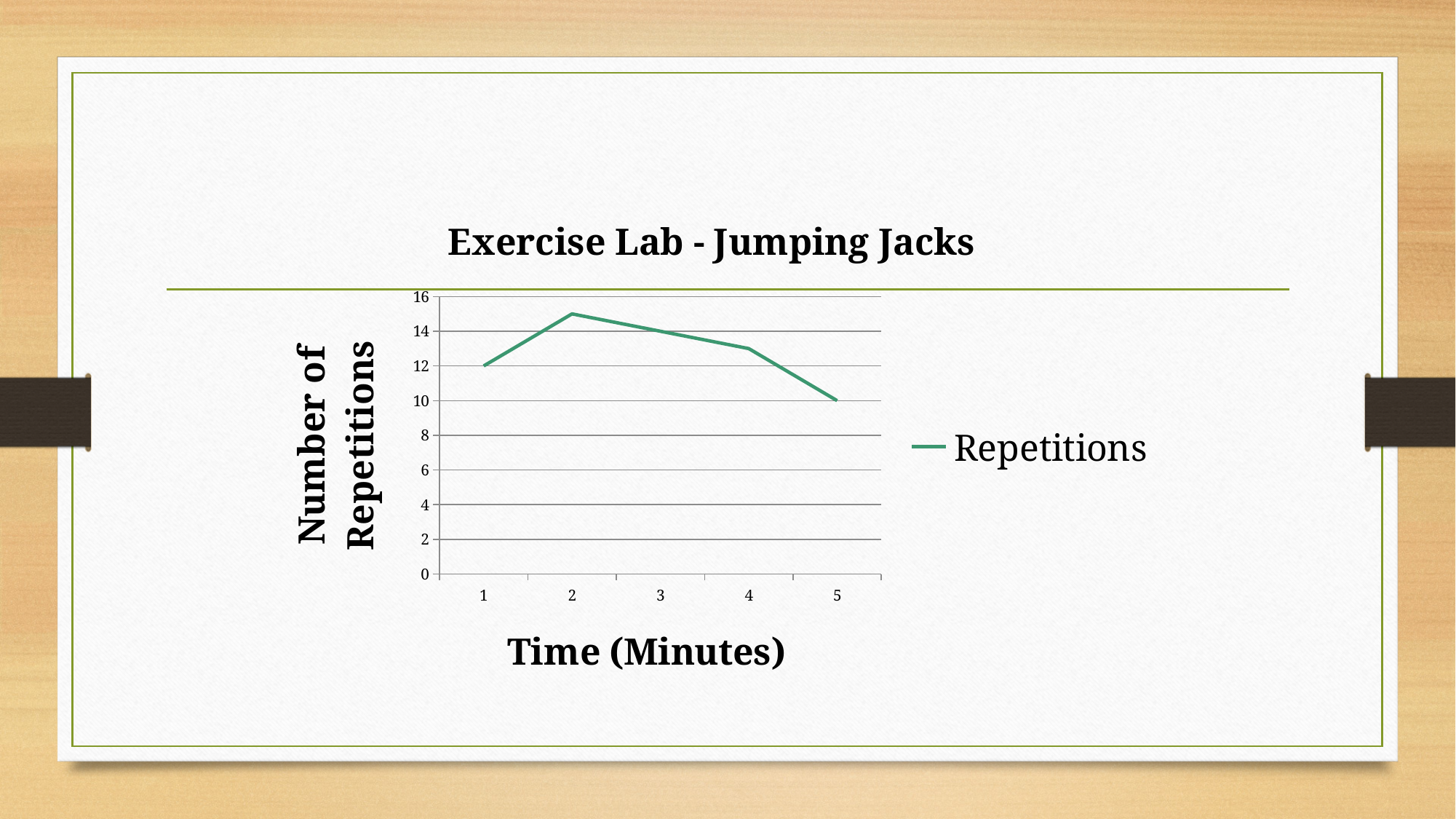
What is the number of repetitions at minute 1? 12 Do the repetitions rise or fall from minute 2 to minute 5? fall What is the number of repetitions at minute 5? 10 What type of chart is shown on the slide? line chart Is the number of repetitions at minute 2 greater or less than 14? greater At which minute is the number of repetitions lowest? 5 How many time points are plotted on the x axis? 5 What is the difference in repetitions between minute 1 and minute 5? 2 How many series does the legend list? 1 What is the title of the chart? Exercise Lab - Jumping Jacks What is the number of repetitions at minute 3? 14 At which minute is the number of repetitions highest? 2